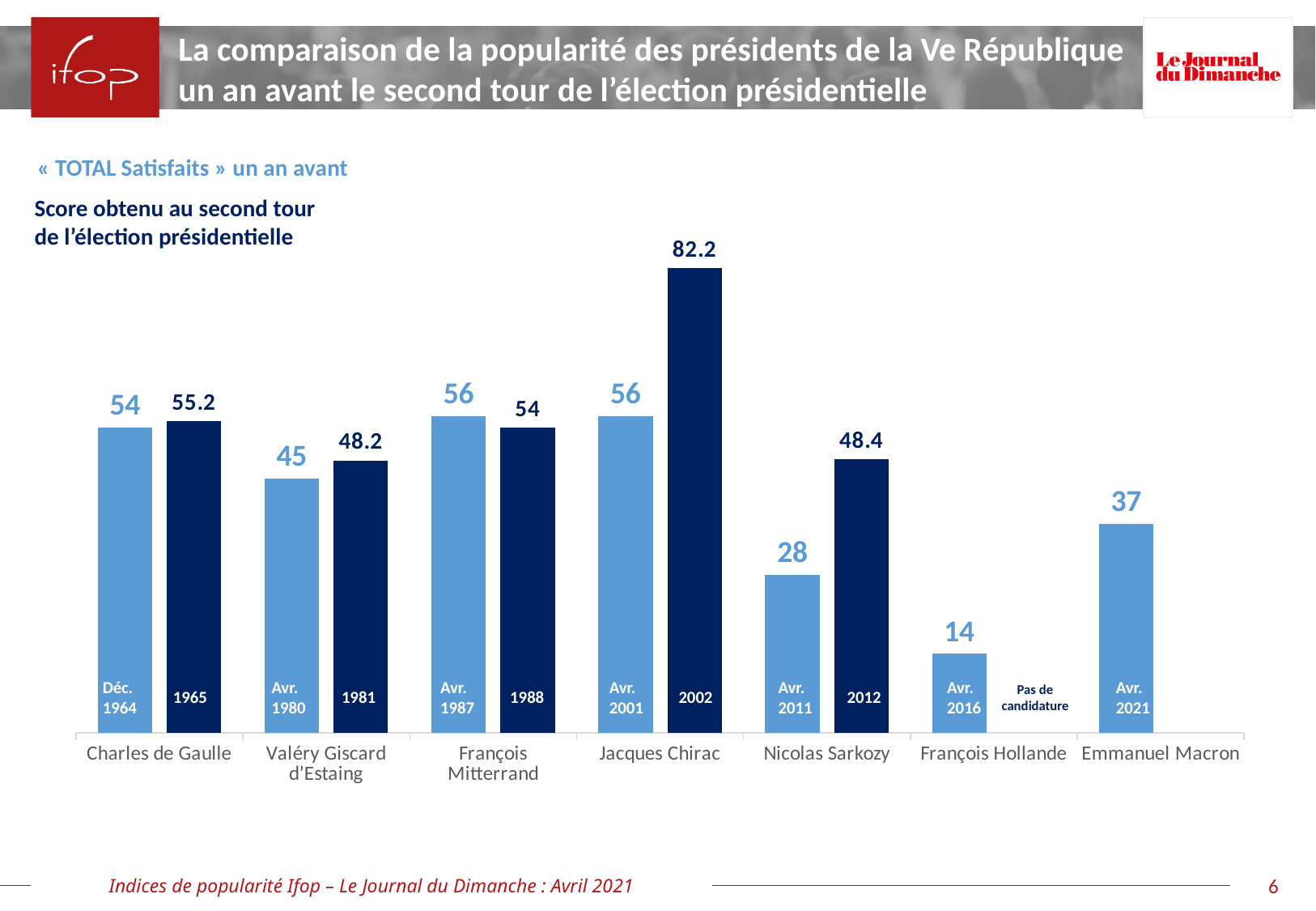
Which president has the lowest "TOTAL Satisfaits" value one year before? François Hollande What is the "TOTAL Satisfaits" value one year before for Nicolas Sarkozy? 28 What score did Jacques Chirac obtain in the second round of the presidential election (2002)? 82.2 What is the difference between Jacques Chirac's second-round score (82.2) and his "TOTAL Satisfaits" value one year before (56)? 26.2 What type of chart is shown on the slide? Bar chart What is the "TOTAL Satisfaits" value one year before for Emmanuel Macron (Avr. 2021)? 37 How many presidents are listed on the x axis of the chart? 7 Which is larger for François Mitterrand: the "TOTAL Satisfaits" value one year before or the second-round score in 1988? TOTAL Satisfaits one year before (56) What is the difference between Nicolas Sarkozy's second-round score in 2012 and his "TOTAL Satisfaits" value in Avr. 2011? 20.4 What second-round score is shown for Valéry Giscard d'Estaing in 1981? 48.2 Which president has the highest second-round election score shown? Jacques Chirac What is shown in place of a second-round score for François Hollande? Pas de candidature